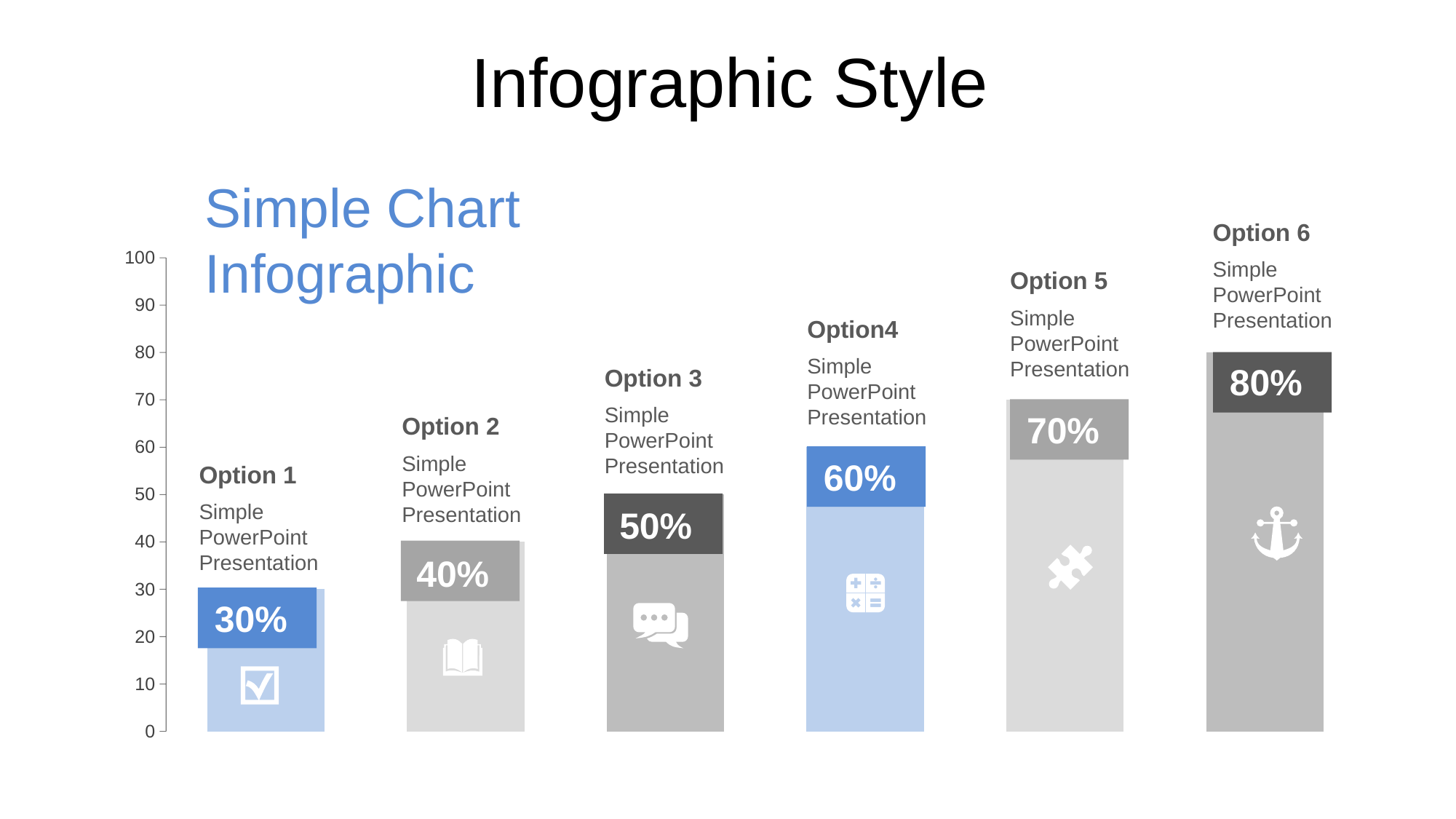
How many options are shown in the chart? 6 What is the value for Option 1? 30% Which option has the highest value? Option 6 Do the values rise or fall from Option 1 to Option 6? rise Which is larger, the value for Option 3 or the value for Option 5? Option 5 Which option has the lowest value? Option 1 What is the value for Option 4? 60% Is the value for Option 3 greater or less than 40? greater What kind of chart is shown on the slide? bar chart What is the difference between the values for Option 5 and Option 2? 30% What is the value for Option 6? 80% What is the blue heading text above the chart? Simple Chart Infographic